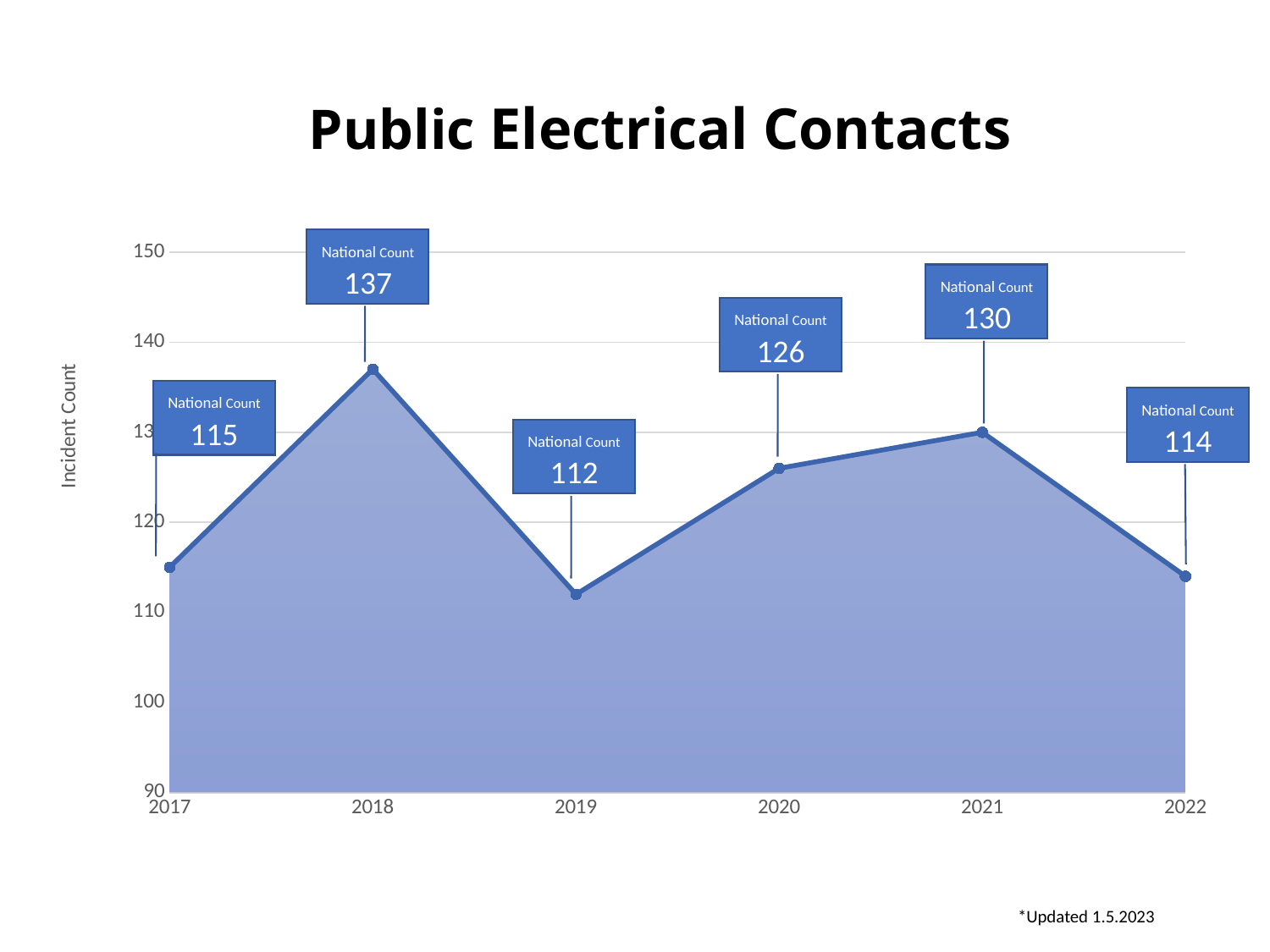
Which year has the highest National Count? 2018 What is the difference between the National Count in 2021 and in 2020? 4 Which year has a larger National Count, 2017 or 2020? 2020 What is the National Count for 2018? 137 What is the difference between the National Count in 2018 and in 2019? 25 How many years are plotted on the chart? 6 What is the National Count for 2022? 114 What kind of chart is shown on the slide? Area chart Which year has the lowest National Count? 2019 What is the National Count for 2019? 112 Is the National Count for 2021 greater or less than 120? greater What is the title of the chart? Public Electrical Contacts